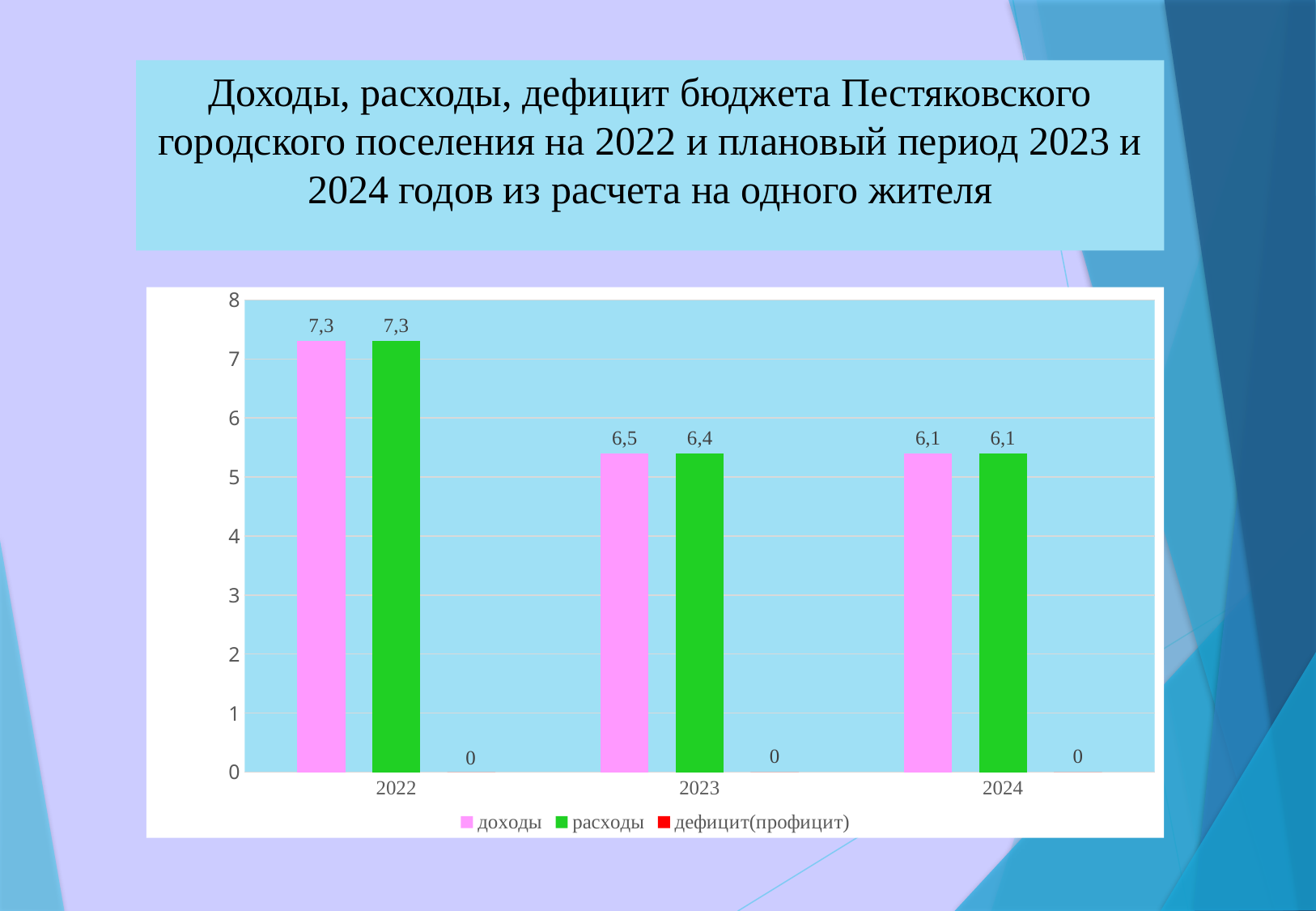
How many years are shown on the x axis? 3 In which year is доходы the highest? 2022 What is the value for доходы in 2022? 7,3 What is the value for расходы in 2023? 6,4 What kind of chart is shown on the slide? bar chart What is the value for дефицит(профицит) in 2023? 0 What is the difference between доходы and расходы in 2023? 0,1 How many series does the legend list? 3 What is the value for доходы in 2024? 6,1 What is the difference between доходы in 2022 and доходы in 2024? 1,2 In which year is расходы the lowest? 2024 Which is larger in 2023, доходы or расходы? доходы